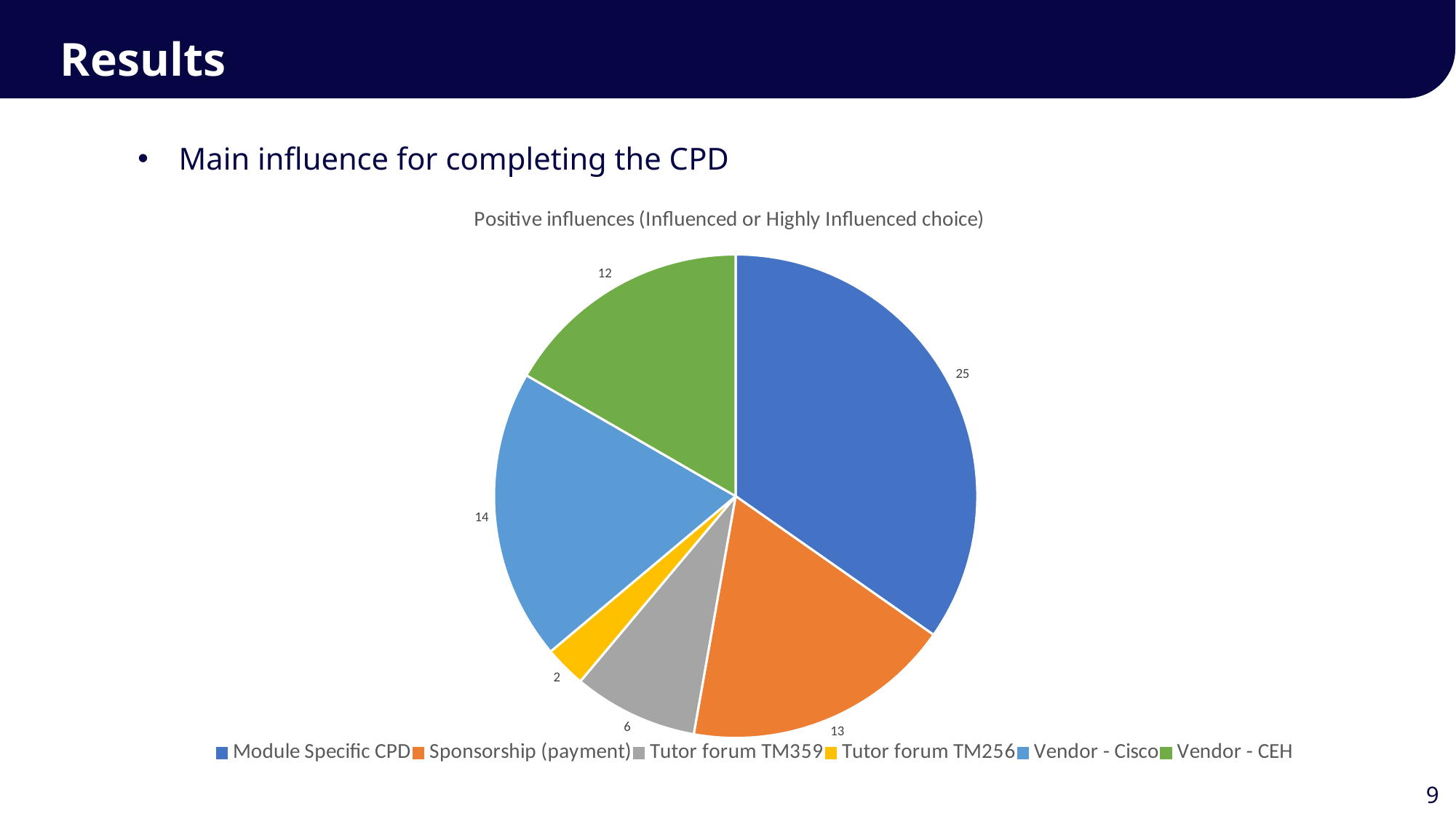
How many categories does the pie chart show? 6 What is the value for Tutor forum TM256? 2 What is the value for Vendor - Cisco? 14 What is the total of all the slices in the pie chart? 72 What is the difference between the values for Module Specific CPD and Sponsorship (payment)? 12 Which category has the smallest slice of the pie? Tutor forum TM256 Which colour represents Tutor forum TM359 in the legend? Grey What kind of chart is shown on the slide? Pie chart Which category has the largest slice of the pie? Module Specific CPD Which is larger, the value for Vendor - Cisco or the value for Vendor - CEH? Vendor - Cisco What is the title of the chart? Positive influences (Influenced or Highly Influenced choice) What is the value for Module Specific CPD? 25